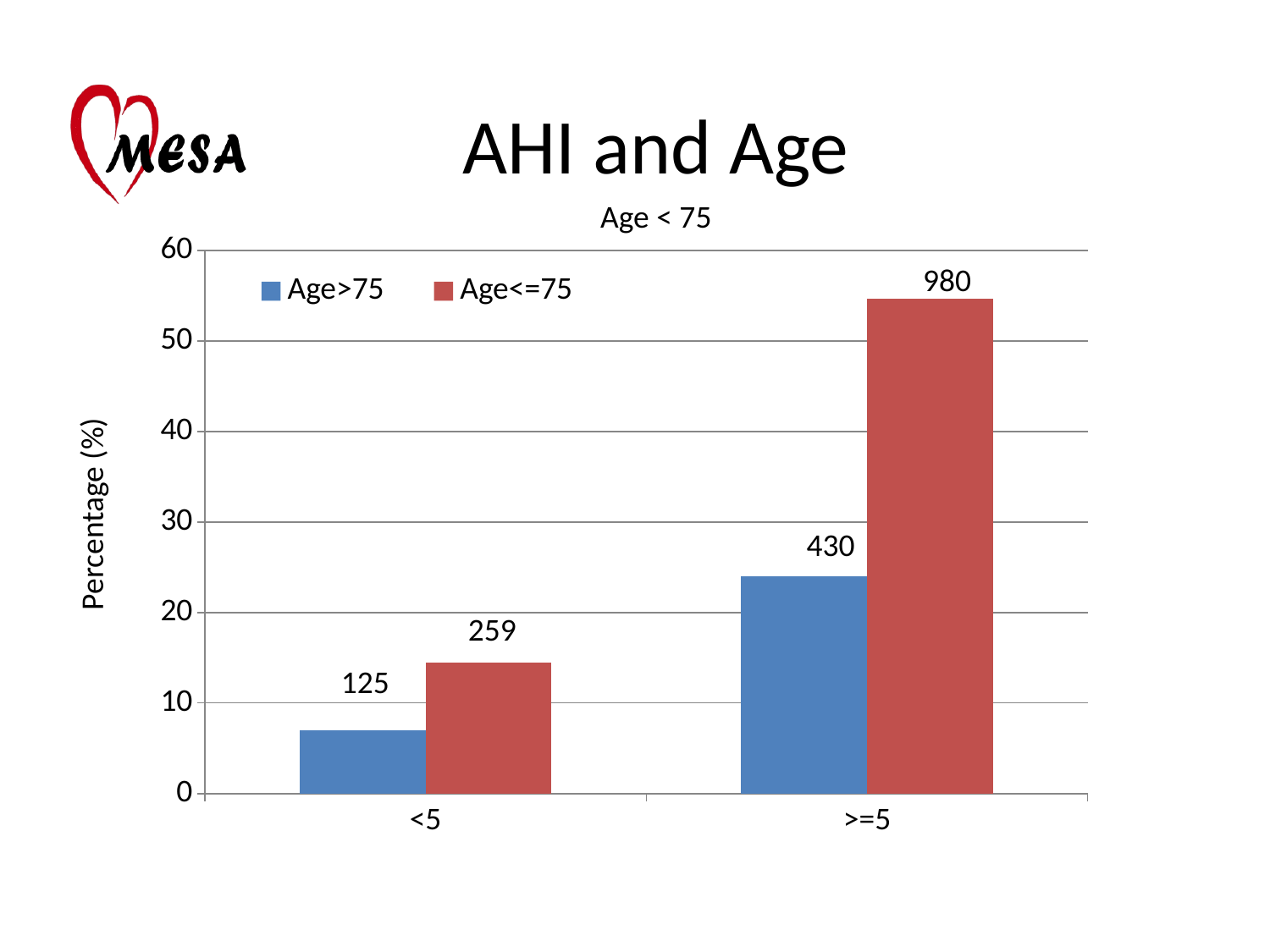
Which bar is the tallest in the chart? Age<=75 for >=5 What is the label on the vertical axis of the chart? Percentage (%) How many series does the legend list? 2 What is the difference between the data labels on the Age<=75 and Age>75 bars for the >=5 category? 550 What data label is shown on the Age>75 bar for the <5 category? 125 Which is taller for the <5 category: the Age>75 bar or the Age<=75 bar? Age<=75 Is the percentage for Age<=75 in the >=5 category greater or less than 50? greater What data label is shown on the Age>75 bar for the >=5 category? 430 Is the percentage for Age>75 in the <5 category greater or less than 10? less What kind of chart is shown on the slide? bar chart Which bar is the shortest in the chart? Age>75 for <5 What data label is shown on the Age<=75 bar for the >=5 category? 980